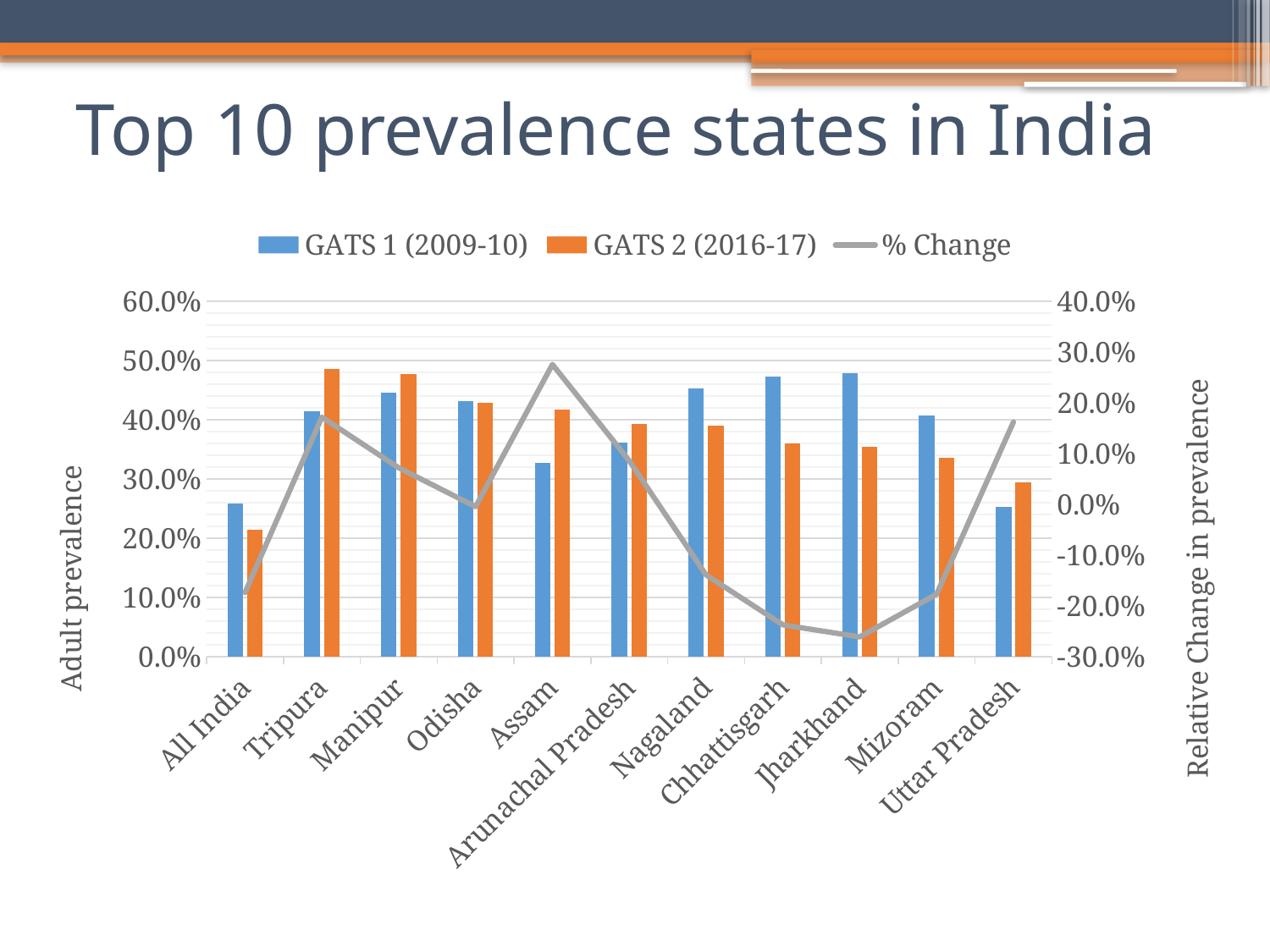
Is the GATS 2 (2016-17) value for Tripura greater or less than 40.0%? greater For Jharkhand, which is larger: the GATS 1 (2009-10) value or the GATS 2 (2016-17) value? GATS 1 (2009-10) What kind of chart is shown on the slide? A combined bar and line chart Is the GATS 1 (2009-10) value for Assam greater or less than 40.0%? less Which category has the highest % Change value? Assam For Assam, which is larger: the GATS 1 (2009-10) value or the GATS 2 (2016-17) value? GATS 2 (2016-17) Is the % Change value for Jharkhand greater or less than -20.0%? less How many categories are shown on the x axis? 11 How many series does the legend list? 3 What is the label of the right-hand vertical axis? Relative Change in prevalence Which category has the lowest GATS 2 (2016-17) value? All India